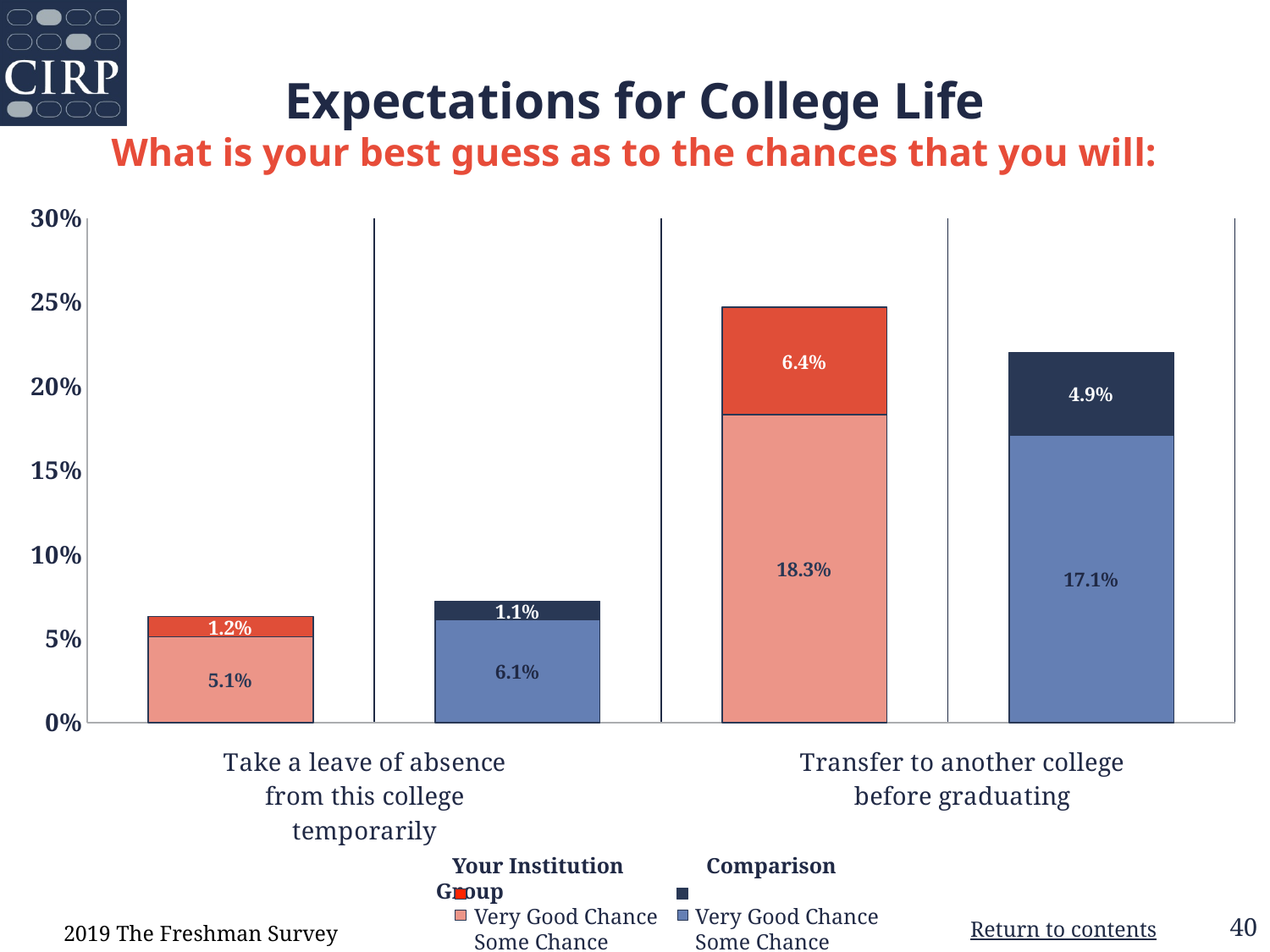
How many series does the chart legend list? 4 What is the total height of the Comparison Group bar for taking a leave of absence from this college temporarily? 7.2% What is the difference between the 'Some Chance' values for Your Institution and the Comparison Group for transferring to another college before graduating? 1.2% Is the total Comparison Group bar for transferring to another college before graduating greater or less than 20%? greater What is the total height of the Your Institution bar for transferring to another college before graduating? 24.7% What percentage of students at Your Institution reported a 'Some Chance' of transferring to another college before graduating? 18.3% What percentage of the Comparison Group reported a 'Very Good Chance' of taking a leave of absence from this college temporarily? 1.1% What is the 'Very Good Chance' value for Your Institution for transferring to another college before graduating? 6.4% Which of the two survey items has the highest stacked bar on the chart? Transfer to another college before graduating Which group has the larger 'Very Good Chance' value for transferring to another college before graduating, Your Institution or the Comparison Group? Your Institution What is the 'Some Chance' value for the Comparison Group for taking a leave of absence from this college temporarily? 6.1% What type of chart is shown on the slide? Stacked bar chart